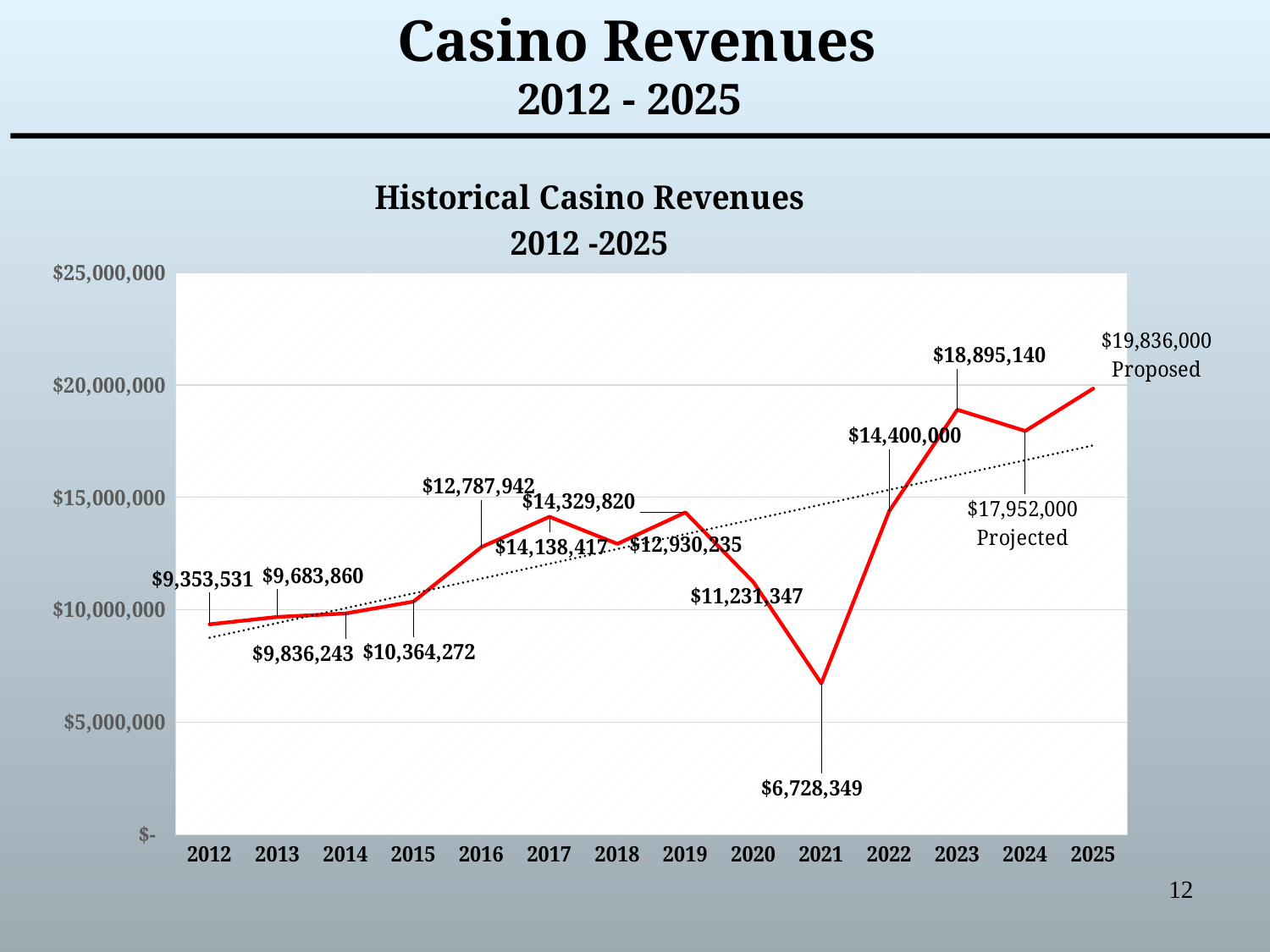
What is the casino revenue for 2023? $18,895,140 What type of chart is shown on the slide? line chart Which year has the larger revenue, 2021 or 2022? 2022 Which year has the lowest casino revenue? 2021 How many years are plotted on the x axis? 14 What is the projected casino revenue for 2024? $17,952,000 What is the proposed casino revenue for 2025? $19,836,000 Is the value for 2015 greater or less than $15,000,000? less Which year has the highest casino revenue? 2025 What is the difference between the 2013 revenue and the 2012 revenue? $330,329 What is the casino revenue for 2021? $6,728,349 What is the casino revenue for 2012? $9,353,531